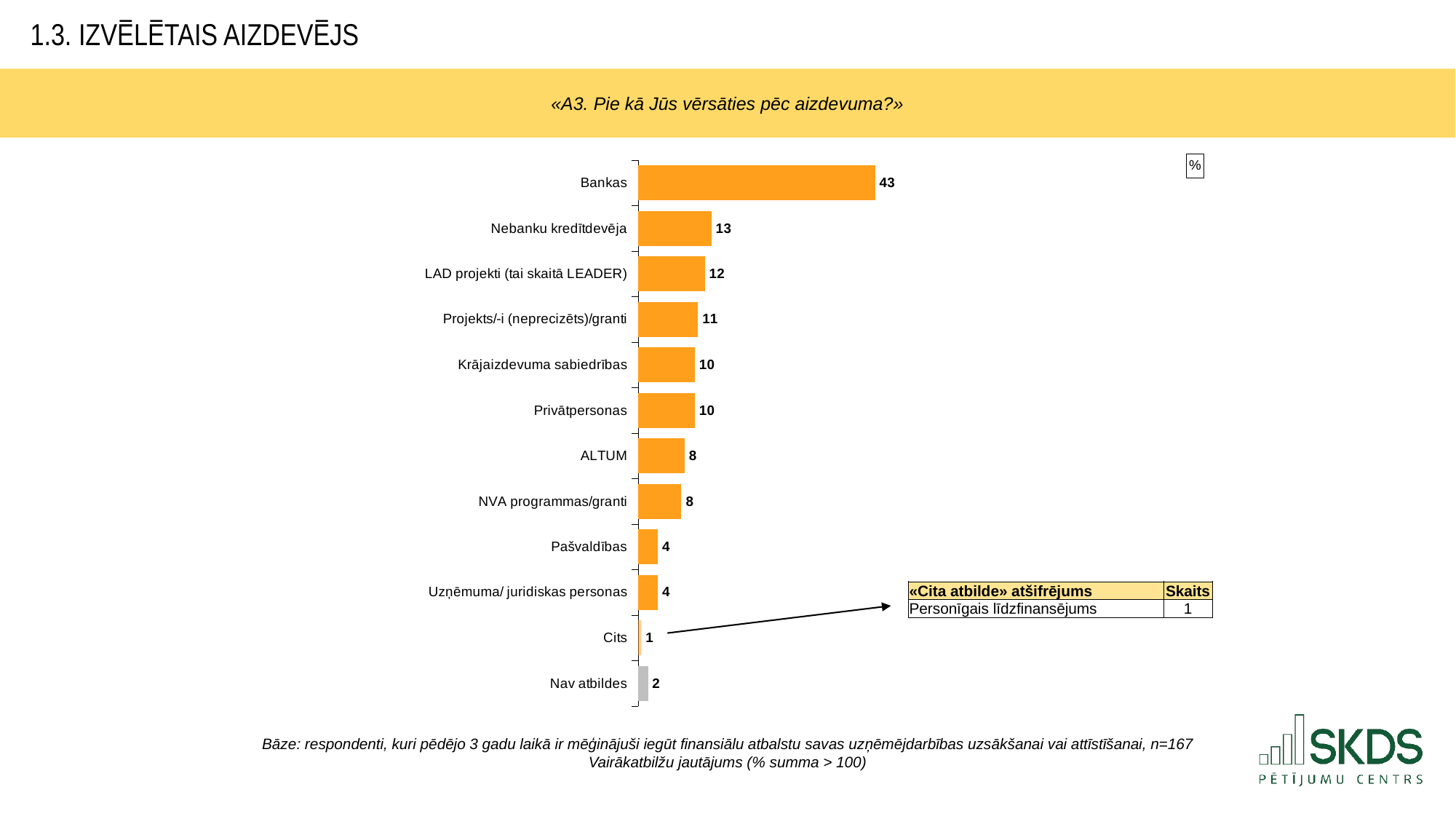
What is the value for ALTUM? 8 Which category has the lowest value? Cits Which is larger, the value for LAD projekti (tai skaitā LEADER) or the value for Pašvaldības? LAD projekti (tai skaitā LEADER) What is the difference between the values for Bankas and Nebanku kredītdevēja? 30 How many categories are shown in the chart? 12 Which category has the highest value? Bankas What is the value for Bankas? 43 What is the value for Nebanku kredītdevēja? 13 What is the value for Nav atbildes? 2 What is the value for Krājaizdevuma sabiedrības? 10 What unit is indicated in the box at the top right of the chart? % What kind of chart is shown on the slide? Bar chart